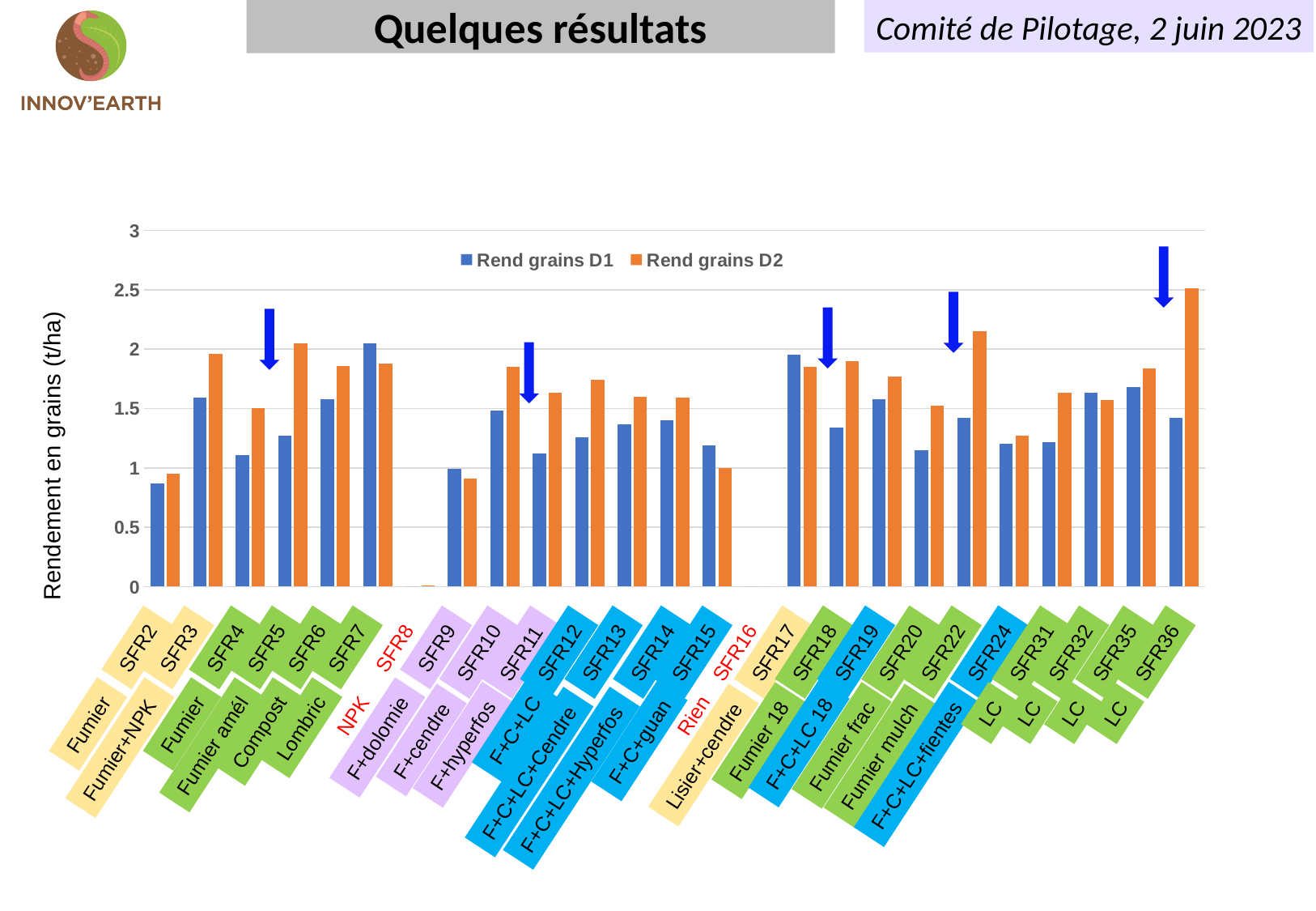
What kind of chart is shown on the slide? bar chart For SFR22, which is larger: Rend grains D1 or Rend grains D2? Rend grains D2 Which category has the highest Rend grains D2 value? SFR36 What is the label of the vertical axis? Rendement en grains (t/ha) Is the Rend grains D2 value for SFR22 greater or less than 2? greater How many series does the chart legend list? 2 For SFR7, which is larger: Rend grains D1 or Rend grains D2? Rend grains D1 How many SFR categories are shown along the x axis? 25 Is the Rend grains D1 value for SFR2 greater or less than 1? less What are the two series named in the legend? Rend grains D1 and Rend grains D2 Is the Rend grains D2 value for SFR36 greater or less than 2? greater